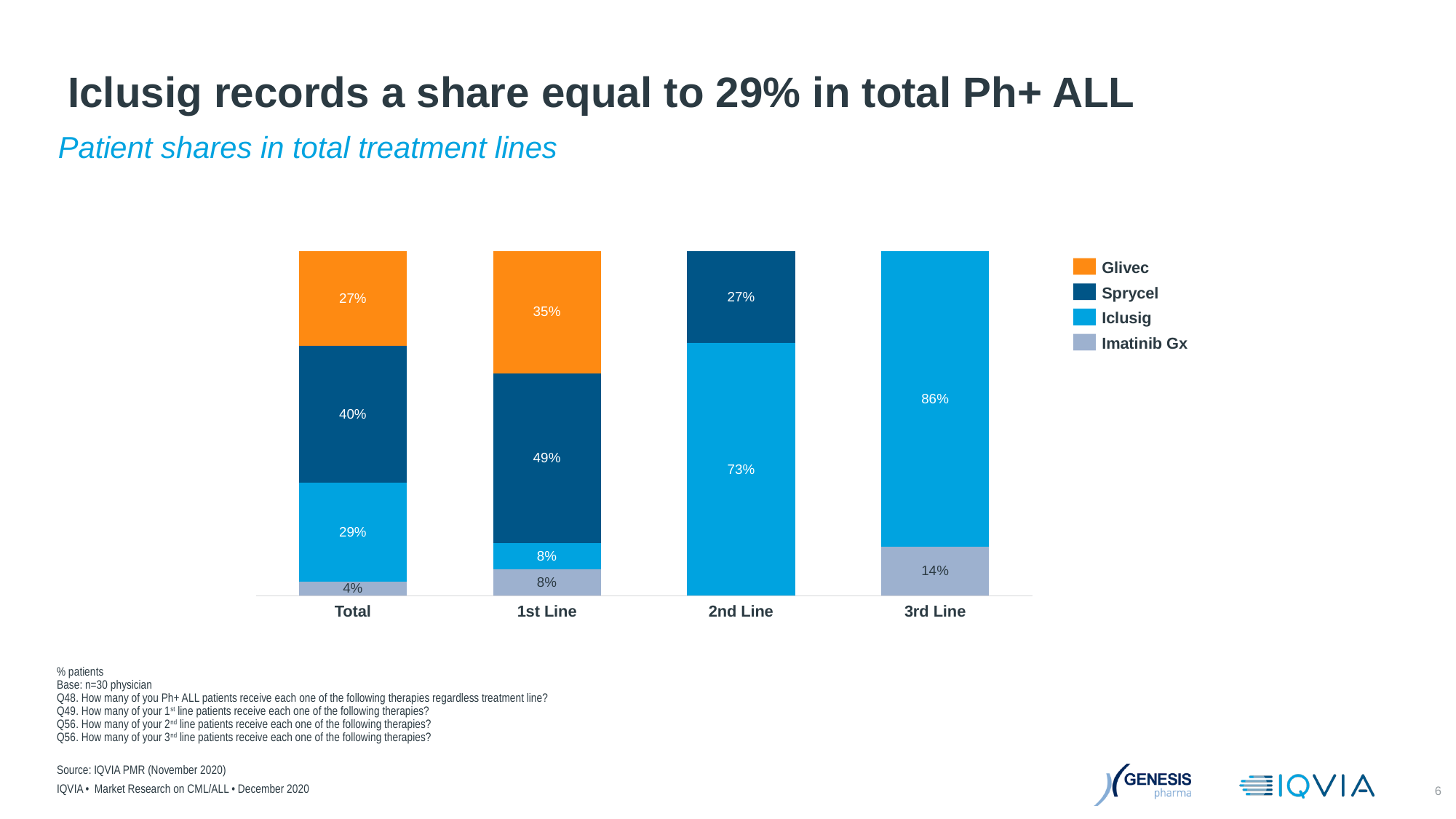
What is the Iclusig share in the Total bar? 29% What is the Iclusig share in the 3rd Line bar? 86% How many series does the legend list? 4 What is the Imatinib Gx share in the Total bar? 4% What is the Sprycel share in the 1st Line bar? 49% What kind of chart is shown on the slide? Stacked bar chart How many categories are shown on the x axis? 4 In which treatment line does Iclusig have its highest share? 3rd Line In which category does Iclusig have its lowest share? 1st Line What is the difference between the Iclusig share in 2nd Line and the Sprycel share in 2nd Line? 46% Which is larger in the Total bar: the Sprycel share or the Glivec share? Sprycel What is the Glivec share in the 1st Line bar? 35%